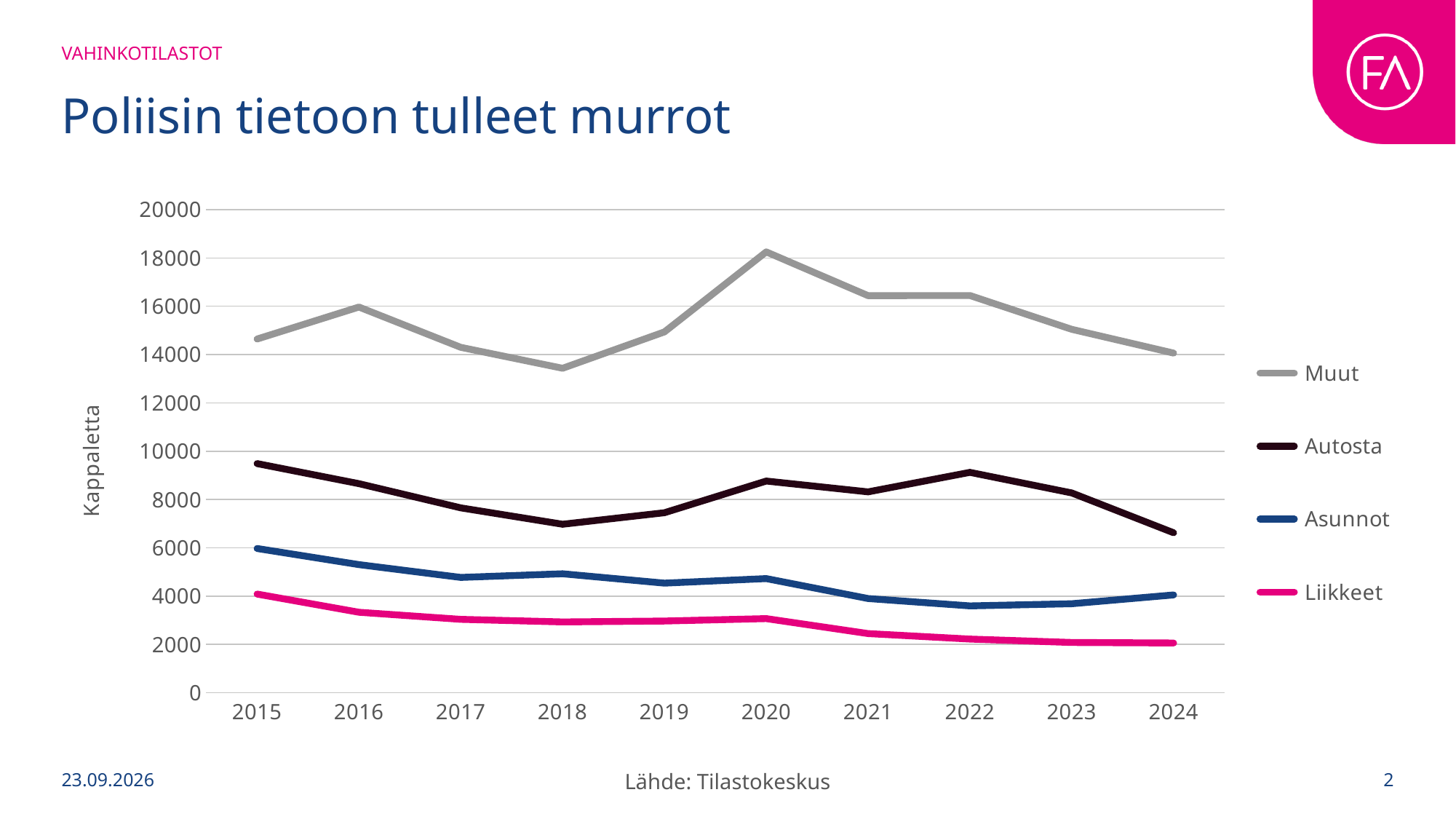
In which year does the Muut series reach its highest value? 2020 Which series has the larger value in 2015, Autosta or Asunnot? Autosta Is the value for Liikkeet in 2024 greater or less than 4000? less How many series does the legend list? 4 What is the label on the y axis? Kappaletta Is the value for Muut in 2020 greater or less than 16000? greater Which year has the larger value for Muut, 2016 or 2018? 2016 What kind of chart is shown on the slide? line chart In which year does the Muut series reach its lowest value? 2018 Is the value for Asunnot in 2022 greater or less than 4000? less Does the Liikkeet series rise or fall from 2015 to 2024? fall How many years are shown on the x axis? 10